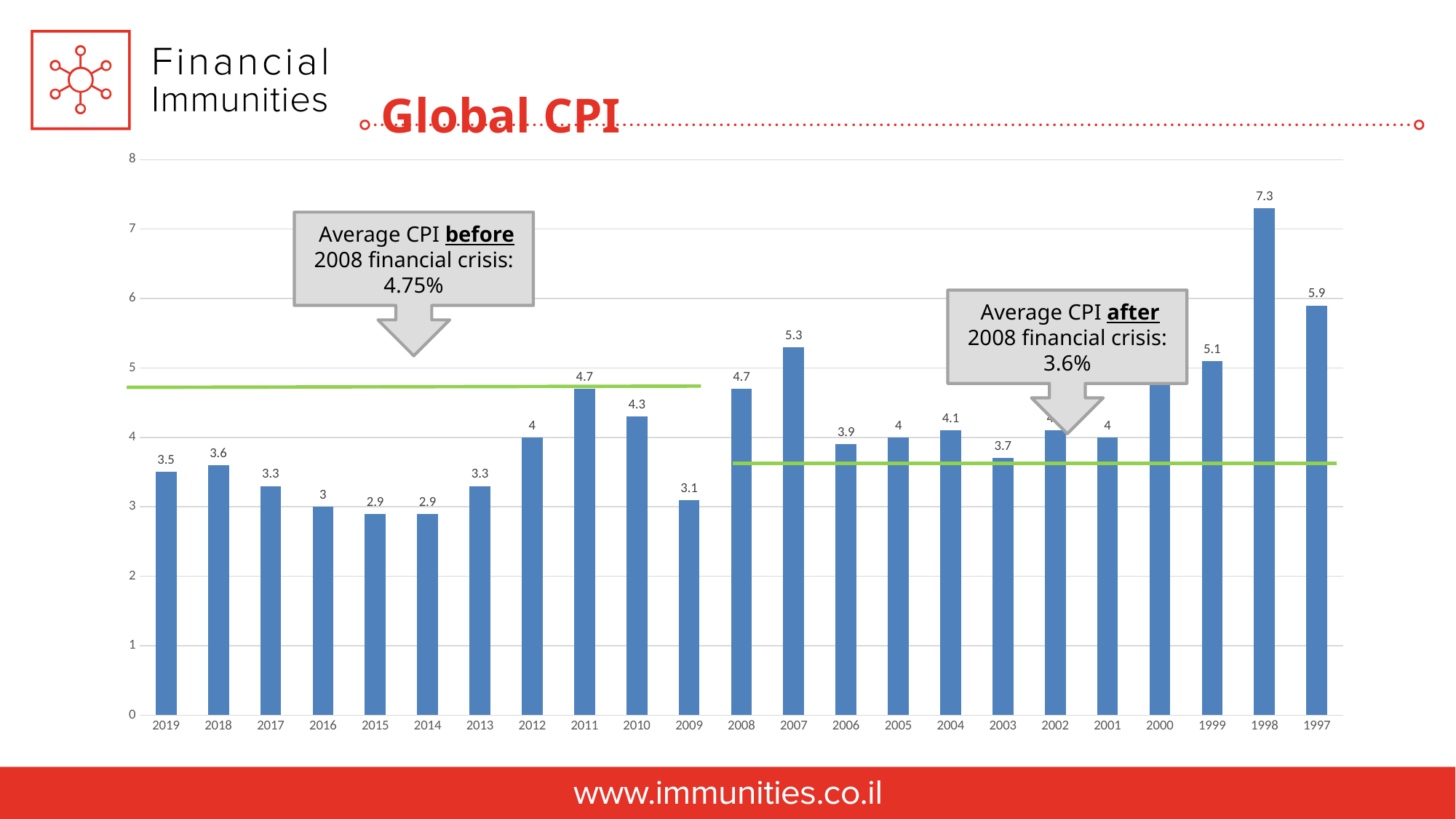
According to the callout, what was the average CPI before the 2008 financial crisis? 4.75% What is the Global CPI value for 2007? 5.3 What is the difference between the Global CPI values for 1998 and 1997? 1.4 What is the Global CPI value for 2009? 3.1 Which year has a larger Global CPI value, 2007 or 1999? 2007 What is the Global CPI value for 2019? 3.5 Is the Global CPI value for 1997 greater or less than 5? greater What is the difference between the Global CPI values for 2011 and 2010? 0.4 How many years are shown on the x axis of the chart? 23 What kind of chart is shown on the slide? bar chart Which year has the highest Global CPI value? 1998 What is the Global CPI value for 1998? 7.3